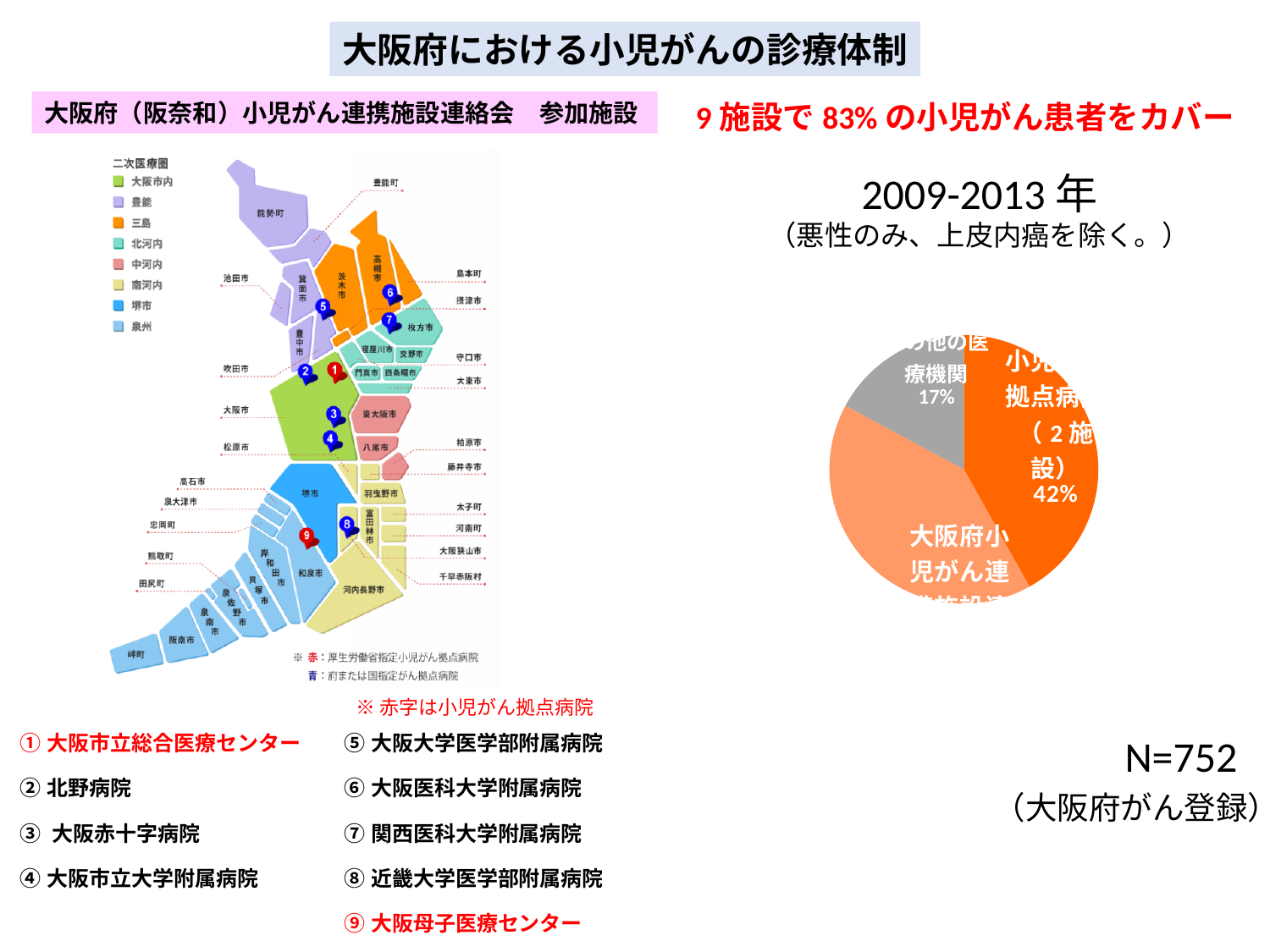
In the pie chart, what is the difference in percentage points between the 小児がん拠点病院（2施設） slice and the その他の医療機関 slice? 25 percentage points In the pie chart, what share is shown for 小児がん拠点病院（2施設）? 42% In the pie chart, which slice is larger: 小児がん拠点病院（2施設） or その他の医療機関? 小児がん拠点病院（2施設） What is the total number of cases (N) stated for the pie chart data? N=752 Which years does the pie chart data cover? 2009-2013年 Which slice of the pie chart is the smallest? その他の医療機関 In the pie chart, what share is shown for その他の医療機関? 17% What kind of chart is shown on the right side of the slide? pie chart How many slices does the pie chart have? 3